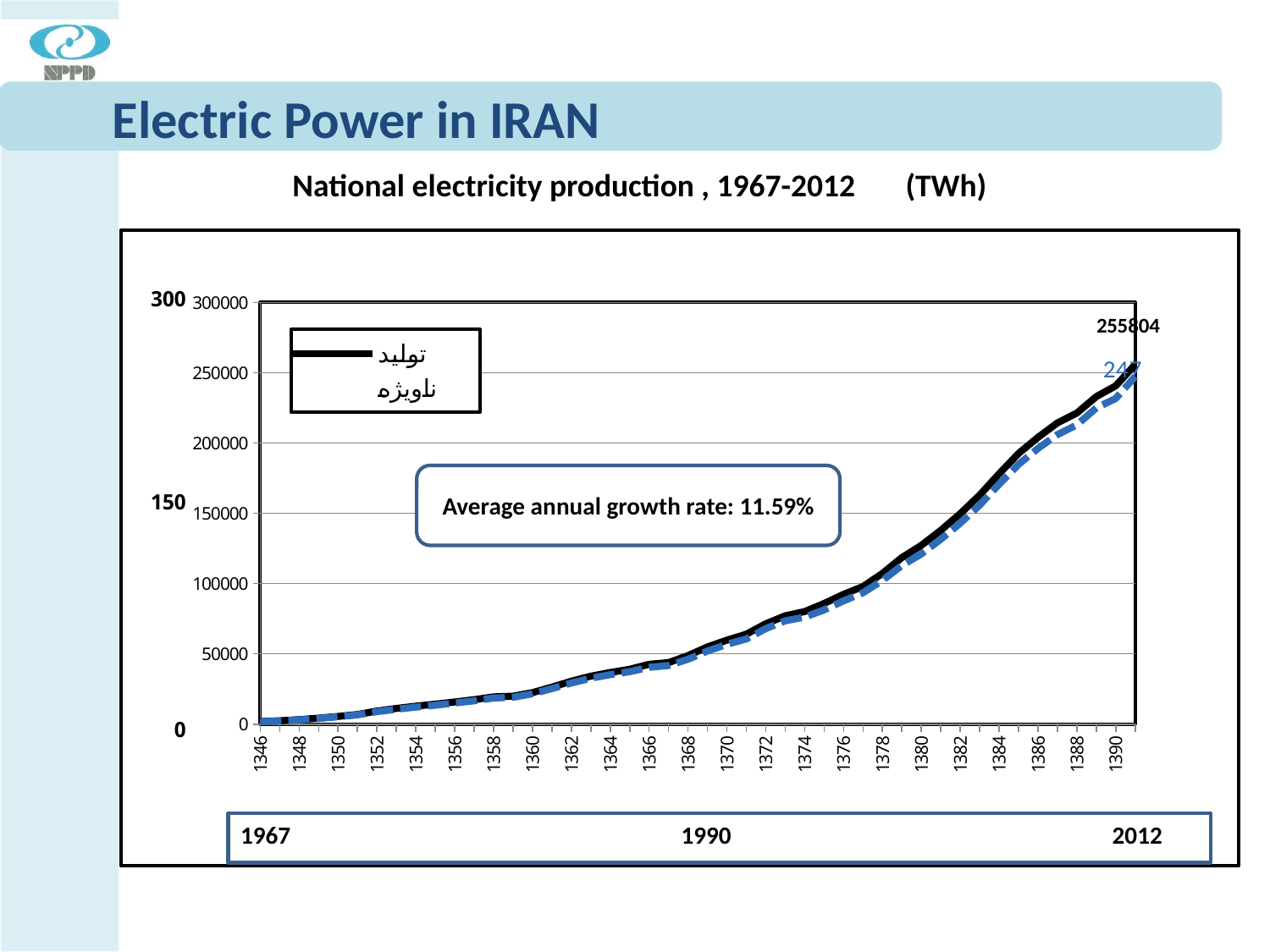
Is the value of the solid black line at 1370 greater or less than 50000? greater Is the value of the dashed blue line at 1384 greater or less than 150000? greater What average annual growth rate is stated in the box on the chart? 11.59% How many series does the chart legend list? 1 What is the title of the chart? National electricity production , 1967-2012 (TWh) Do the values rise or fall along the x axis from 1346 to 1390? rise What kind of chart is shown on the slide? line chart At the right end of the chart, which line is higher: the solid black line or the dashed blue line? solid black line Is the value of the solid black line at 1360 greater or less than 50000? less What is the data label shown at the end of the solid black line? 255804